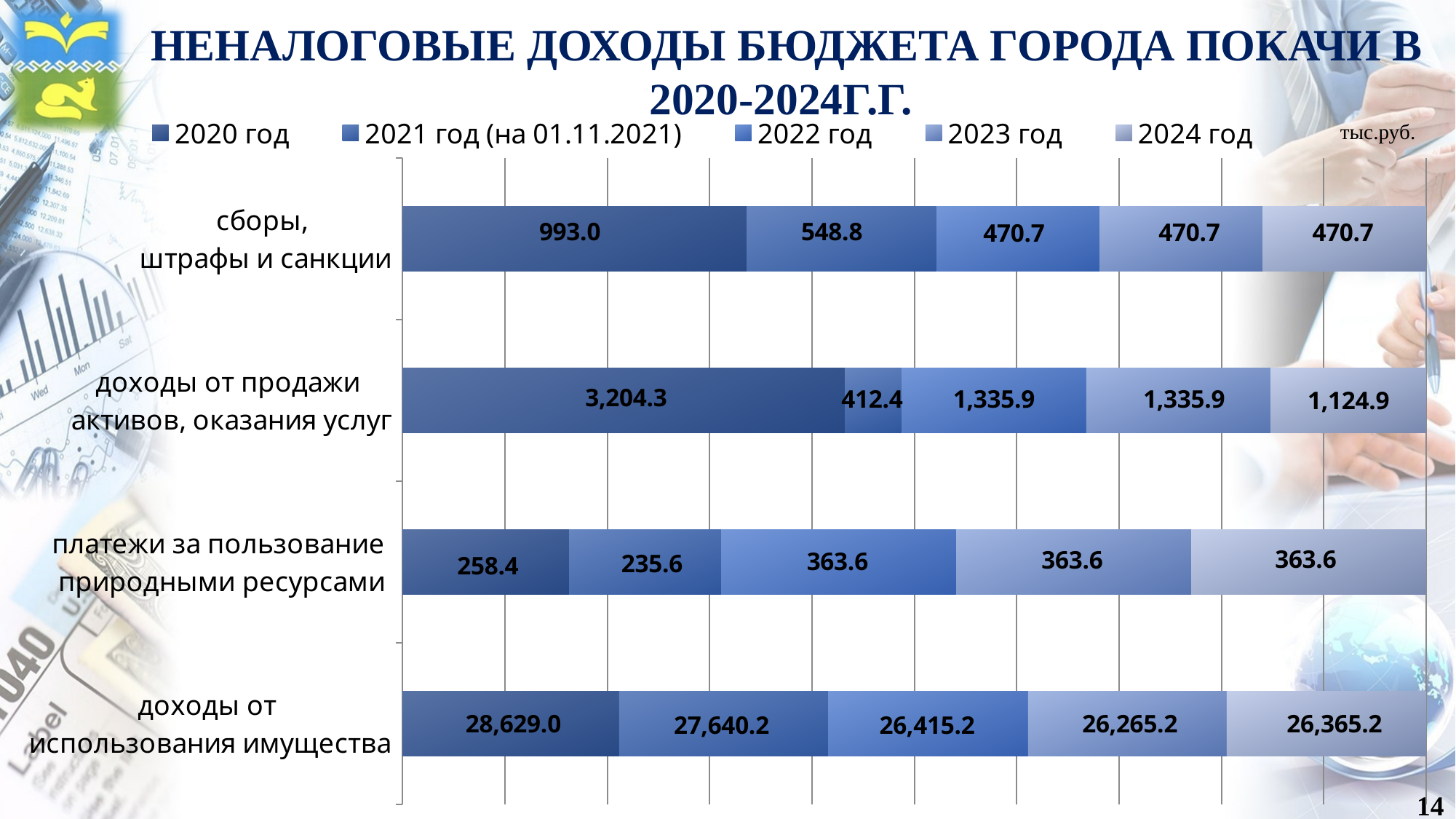
What is the value for 2024 год for «доходы от использования имущества»? 26,365.2 What is the value for 2020 год for the category «сборы, штрафы и санкции»? 993.0 What kind of chart is shown on the slide? bar chart How many categories are shown on the chart? 4 What is the value for 2021 год (на 01.11.2021) for «доходы от продажи активов, оказания услуг»? 412.4 For «доходы от использования имущества», which is larger: the 2022 год value or the 2023 год value? 2022 год What is the value for 2022 год for «платежи за пользование природными ресурсами»? 363.6 Which category has the lowest value for 2020 год? платежи за пользование природными ресурсами How many series does the legend list? 5 Which category has the highest value for 2020 год? доходы от использования имущества What is the difference between the 2020 год and 2021 год values for «доходы от использования имущества»? 988.8 What is the total of all five year values in the bar for «платежи за пользование природными ресурсами»? 1,584.8